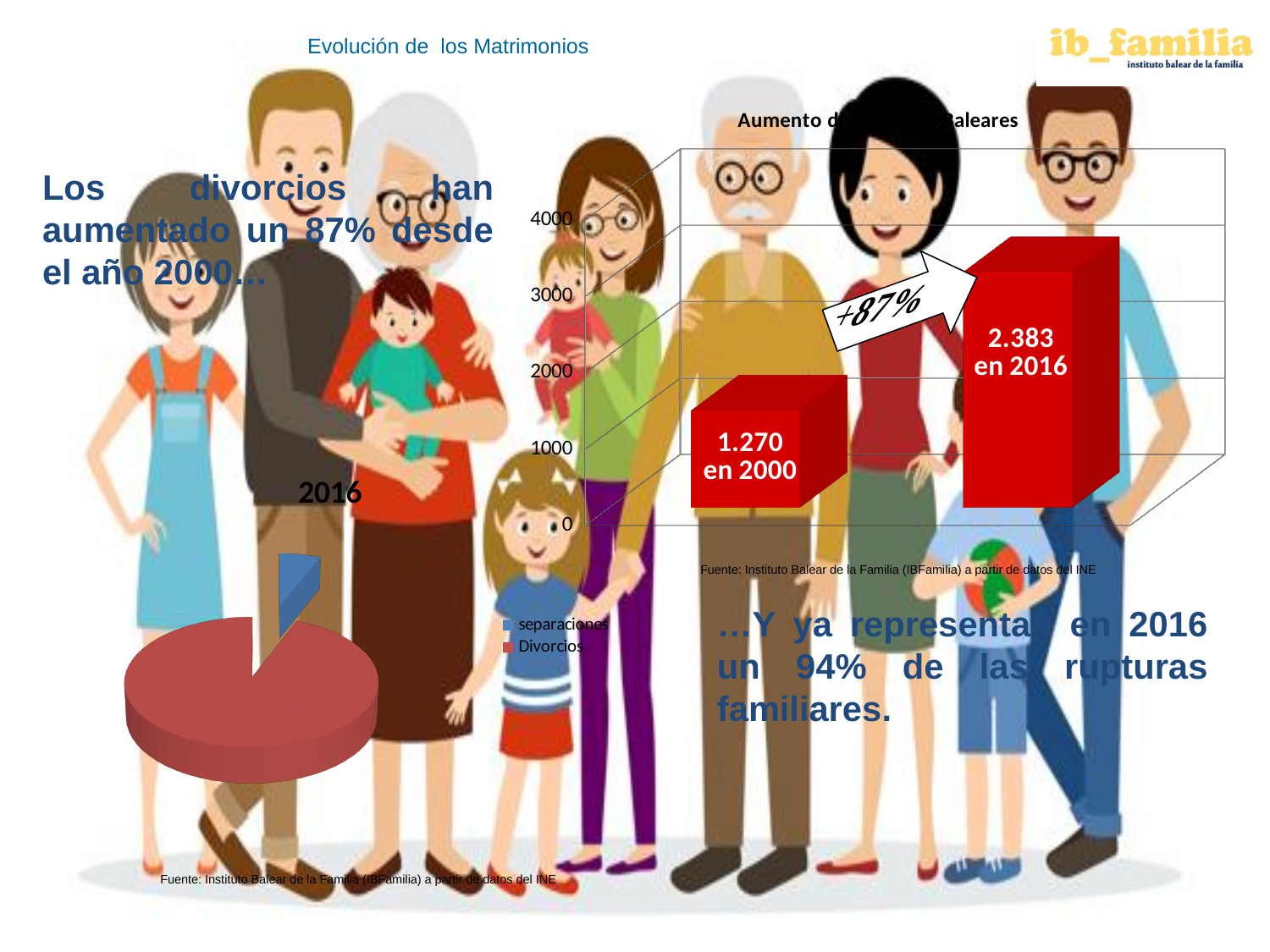
In the bar chart on the right, do the values rise or fall from 2000 to 2016? rise In the pie chart on the bottom left, which slice is larger, separaciones or Divorcios? Divorcios In the bar chart on the right, is the value for 2000 greater or less than 2000 on the axis? less In the bar chart on the right, what is the value for the year 2000? 1.270 In the bar chart on the right, which year has the higher value? 2016 What kind of chart is the chart on the right of the slide? bar chart In the bar chart on the right, how many bars are plotted? 2 In the bar chart on the right, what is the difference between the 2016 value and the 2000 value? 1.113 In the bar chart on the right, what is the value for the year 2016? 2.383 In the bar chart on the right, what percentage increase is written on the arrow between the two bars? +87% How many entries does the legend of the pie chart on the bottom left list? 2 In the bar chart on the right, which year has the lower value? 2000